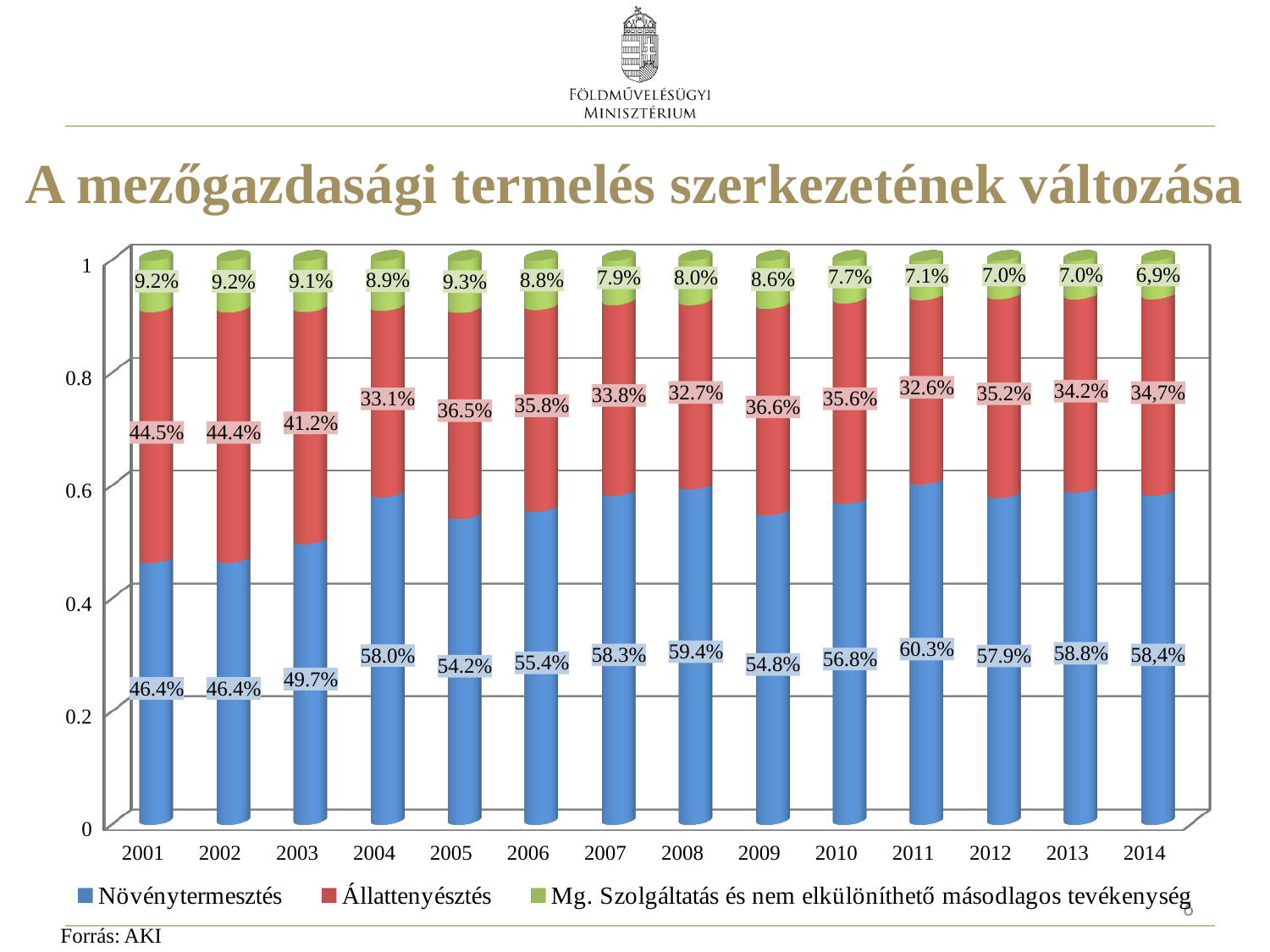
What is the title of the chart? A mezőgazdasági termelés szerkezetének változása Does the Mg. Szolgáltatás és nem elkülöníthető másodlagos tevékenység share generally rise or fall from 2001 to 2014? Fall What is the value for Növénytermesztés in 2011? 60.3% What kind of chart is shown on the slide? Stacked bar chart In which year is the Növénytermesztés share the highest? 2011 What is the value for Állattenyésztés in 2003? 41.2% In which year is the Mg. Szolgáltatás és nem elkülöníthető másodlagos tevékenység share the lowest? 2014 Which is larger, the Növénytermesztés value in 2004 or in 2009? 2004 How many years are shown on the x axis? 14 What is the value for Mg. Szolgáltatás és nem elkülöníthető másodlagos tevékenység in 2005? 9.3% What is the difference between the Állattenyésztés value in 2001 and in 2014? 9.8 percentage points How many series does the legend list? 3